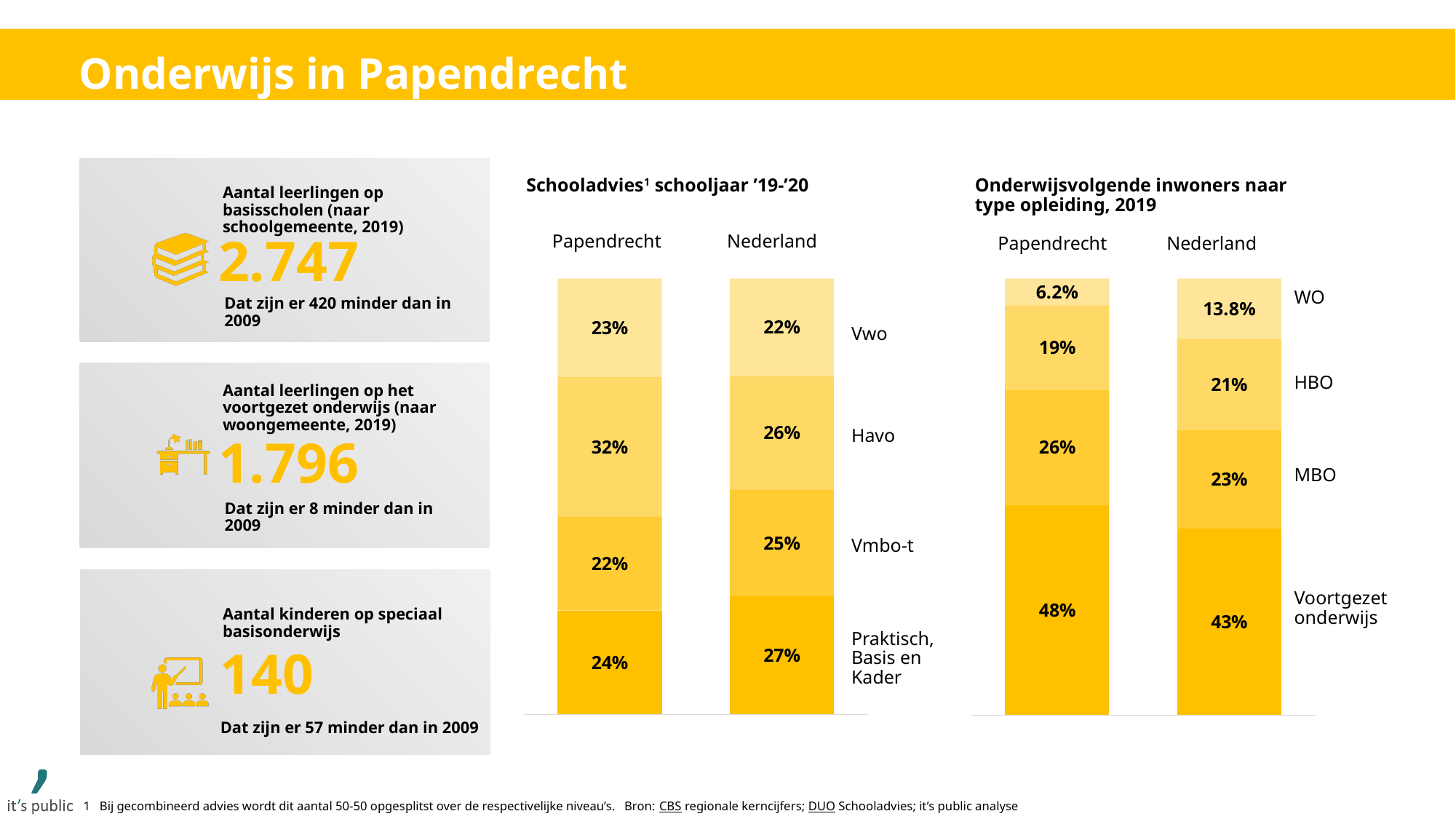
What kind of chart is the 'Schooladvies schooljaar '19-'20' chart? Stacked bar chart In the 'Onderwijsvolgende inwoners naar type opleiding, 2019' chart, is the HBO share larger for Papendrecht or for Nederland? Nederland In the 'Onderwijsvolgende inwoners naar type opleiding, 2019' chart, which category has the largest share in the Nederland bar? Voortgezet onderwijs In the 'Onderwijsvolgende inwoners naar type opleiding, 2019' chart, what is the WO share for Papendrecht? 6.2% In the 'Schooladvies schooljaar '19-'20' chart, is the Praktisch, Basis en Kader share larger for Papendrecht or for Nederland? Nederland In the 'Onderwijsvolgende inwoners naar type opleiding, 2019' chart, what is the MBO share for Nederland? 23% In the 'Schooladvies schooljaar '19-'20' chart, what is the Havo share for Papendrecht? 32% In the 'Onderwijsvolgende inwoners naar type opleiding, 2019' chart, how many education types are stacked in each bar? 4 In the 'Schooladvies schooljaar '19-'20' chart, what is the difference between the Havo share for Papendrecht and for Nederland? 6 percentage points In the 'Schooladvies schooljaar '19-'20' chart, which category has the smallest share in the Nederland bar? Vwo In the 'Schooladvies schooljaar '19-'20' chart, what is the Vmbo-t share for Nederland? 25% In the 'Schooladvies schooljaar '19-'20' chart, which category has the largest share in the Papendrecht bar? Havo